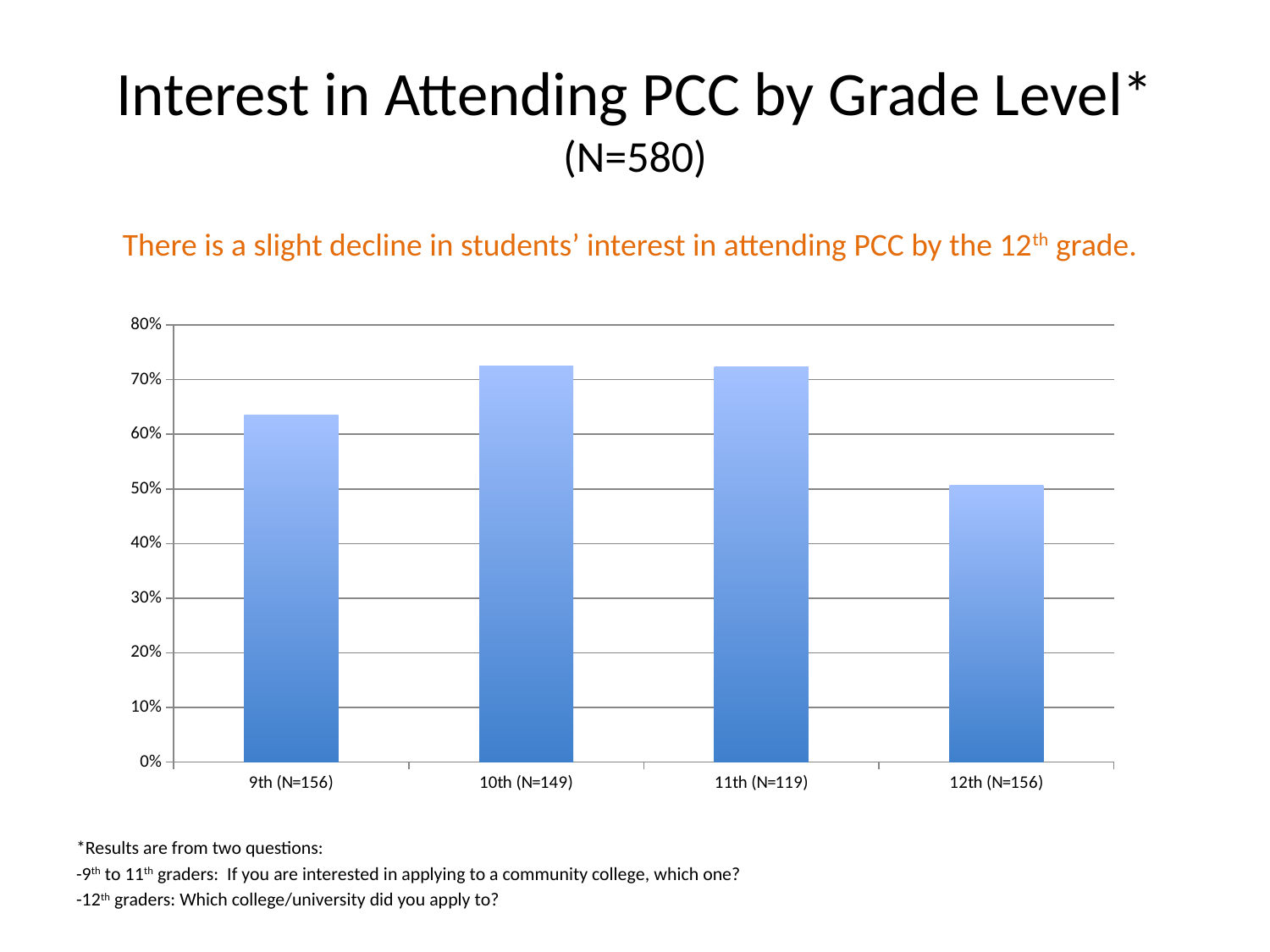
Is the value for 10th (N=149) greater or less than 70%? greater How many grade-level categories are plotted on the chart? 4 What kind of chart is shown on the slide? bar chart Is the value for 9th (N=156) greater or less than 60%? greater What is the title of the slide containing the chart? Interest in Attending PCC by Grade Level* (N=580) Which is larger, the value for 9th (N=156) or the value for 10th (N=149)? 10th (N=149) Which grade level has the lowest interest in attending PCC? 12th (N=156) What is the highest value shown on the chart's vertical axis? 80% Which is larger, the value for 9th (N=156) or the value for 12th (N=156)? 9th (N=156) Is the value for 12th (N=156) greater or less than 60%? less